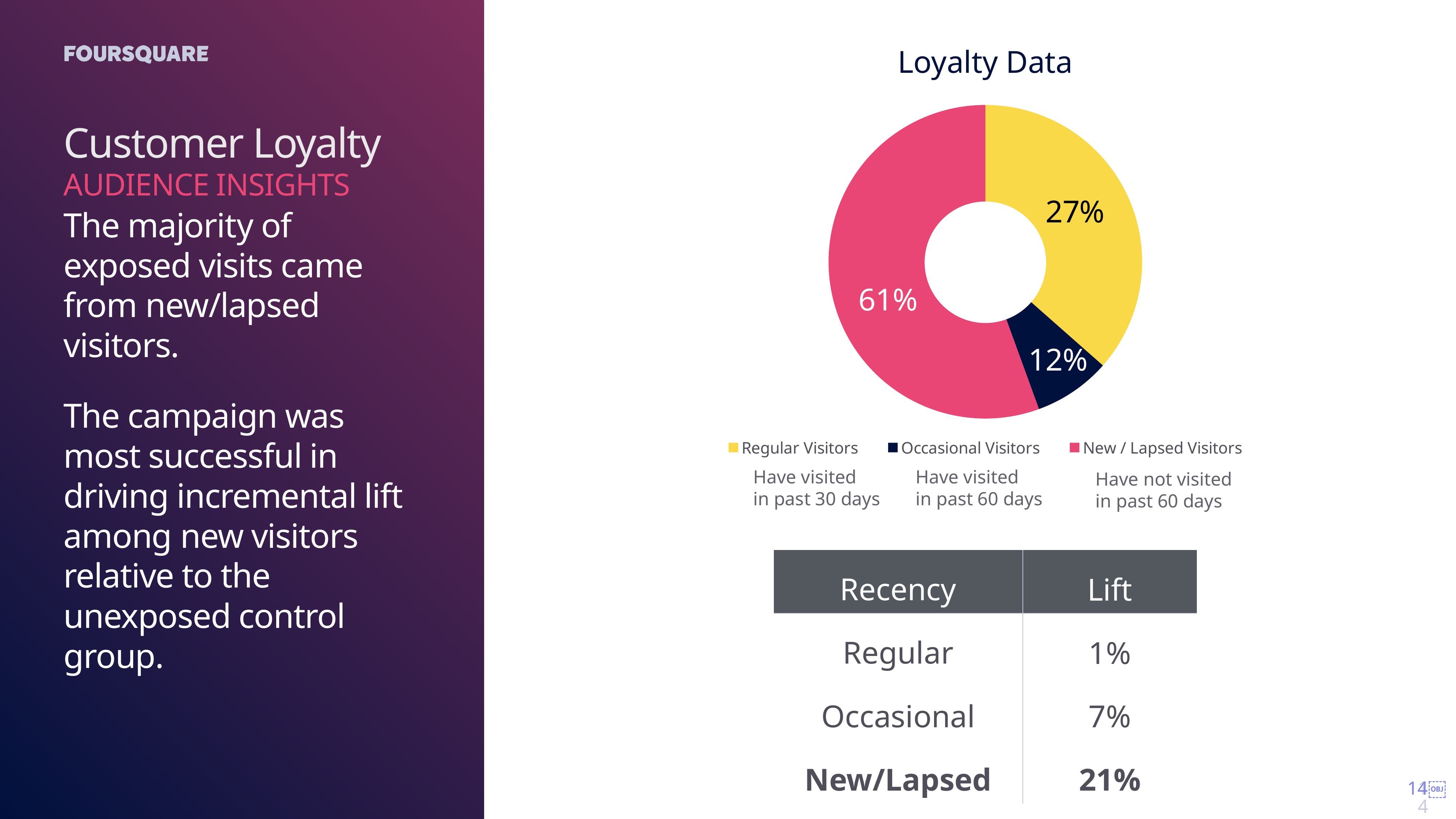
What share of the pie do Regular Visitors represent? 27% Which category has the smallest slice of the pie? Occasional Visitors What is the difference in percentage points between Regular Visitors and Occasional Visitors? 15 What kind of chart is shown on the slide? Pie chart (doughnut) What is the title of the chart? Loyalty Data What is the difference in percentage points between New / Lapsed Visitors and Regular Visitors? 34 What share of the pie do Occasional Visitors represent? 12% What colour is the slice for New / Lapsed Visitors? Pink Which is larger, the share for Regular Visitors or the share for Occasional Visitors? Regular Visitors What share of the pie do New / Lapsed Visitors represent? 61% Which category has the largest slice of the pie? New / Lapsed Visitors How many categories does the pie chart show? 3